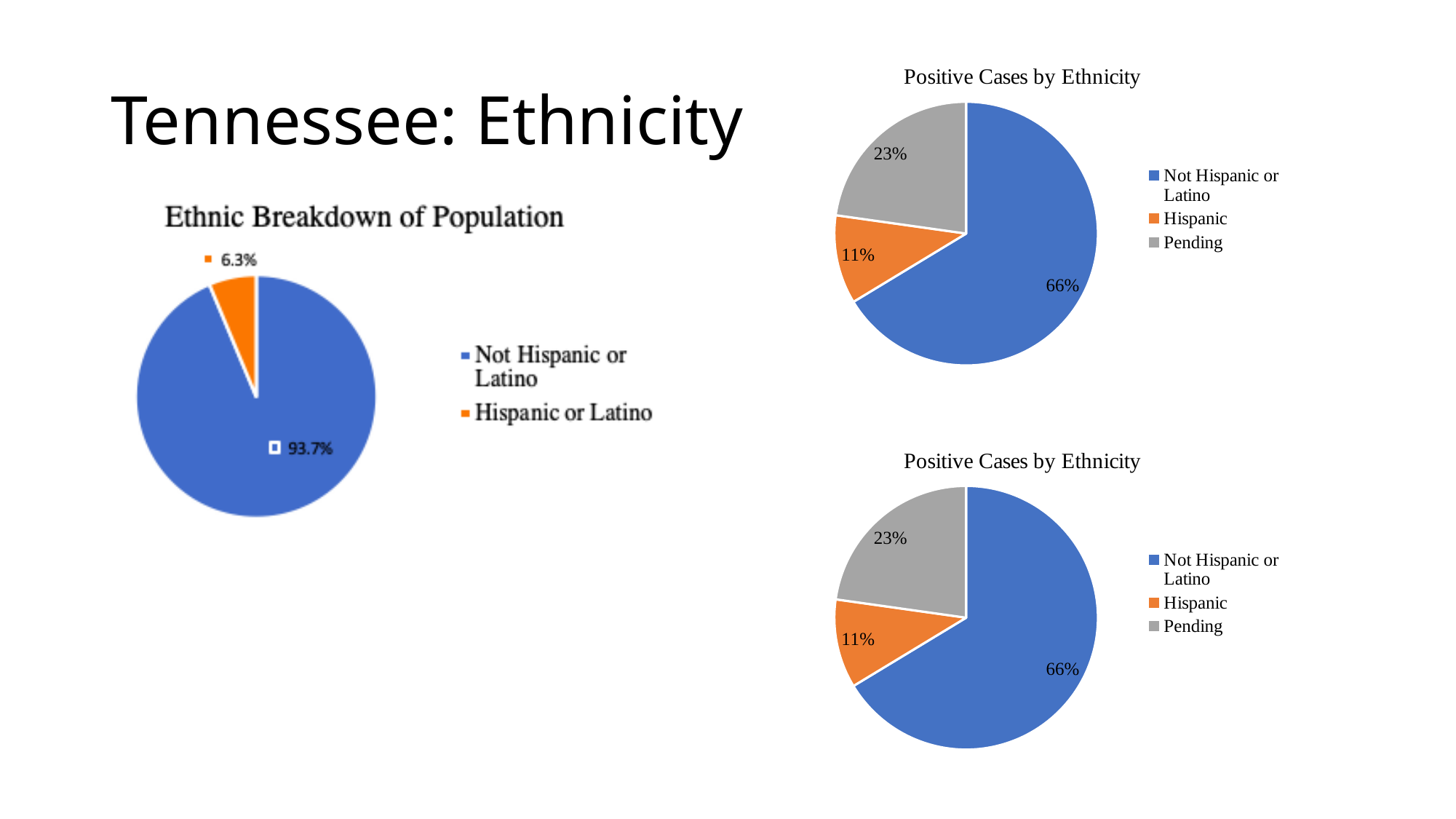
In the bottom-right 'Positive Cases by Ethnicity' chart, what is the difference between the Pending share and the Hispanic share? 12% In the 'Ethnic Breakdown of Population' chart, what share of the population is Hispanic or Latino? 6.3% In the 'Ethnic Breakdown of Population' chart, what is the difference between the Not Hispanic or Latino share and the Hispanic or Latino share? 87.4% What type of chart is the 'Ethnic Breakdown of Population' chart? Pie chart In the bottom-right 'Positive Cases by Ethnicity' chart, which category has the smallest slice? Hispanic In the 'Ethnic Breakdown of Population' chart, how many categories does the legend list? 2 In the 'Ethnic Breakdown of Population' chart, what share of the population is Not Hispanic or Latino? 93.7% In the top-right 'Positive Cases by Ethnicity' chart, what percentage of positive cases is Hispanic? 11% In the top-right 'Positive Cases by Ethnicity' chart, what percentage of positive cases is Not Hispanic or Latino? 66% In the top-right 'Positive Cases by Ethnicity' chart, what percentage of positive cases is Pending? 23% In the 'Ethnic Breakdown of Population' chart, which category has the largest slice? Not Hispanic or Latino In the bottom-right 'Positive Cases by Ethnicity' chart, how many categories does the legend list? 3